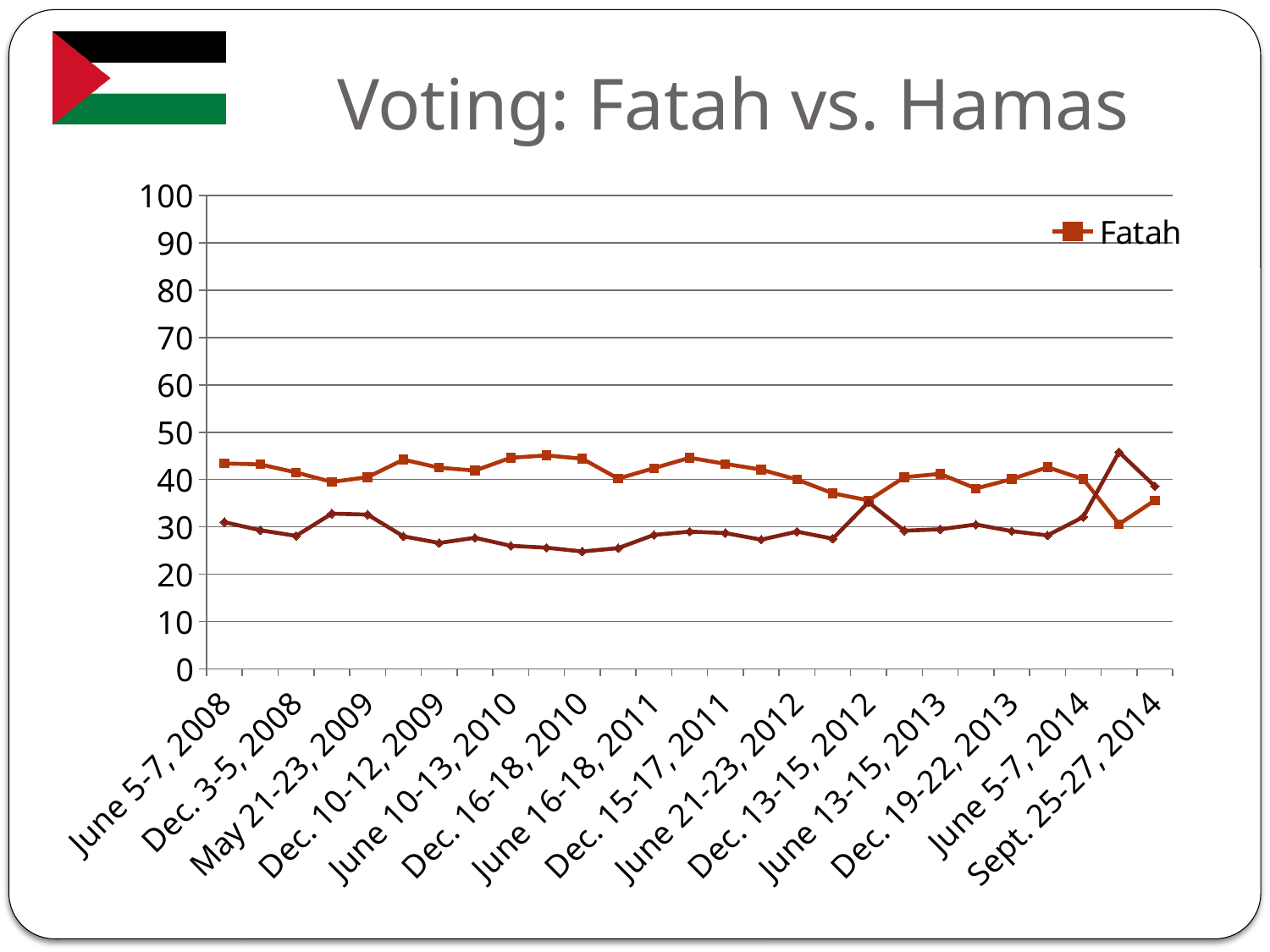
Does the Fatah line end higher or lower at Sept. 25-27, 2014 than it started at June 5-7, 2008? lower Is the value of the diamond-marker line for Dec. 16-18, 2010 greater or less than 30? less Is the Fatah value for Sept. 25-27, 2014 greater or less than 40? less Is the Fatah value for Dec. 16-18, 2010 greater or less than 40? greater At June 5-7, 2008, which line is higher: the Fatah line or the diamond-marker line? Fatah What kind of chart is shown on the slide? line chart Which series name appears in the chart's legend? Fatah What is the title of the slide's chart? Voting: Fatah vs. Hamas How many series does the chart's legend list? 1